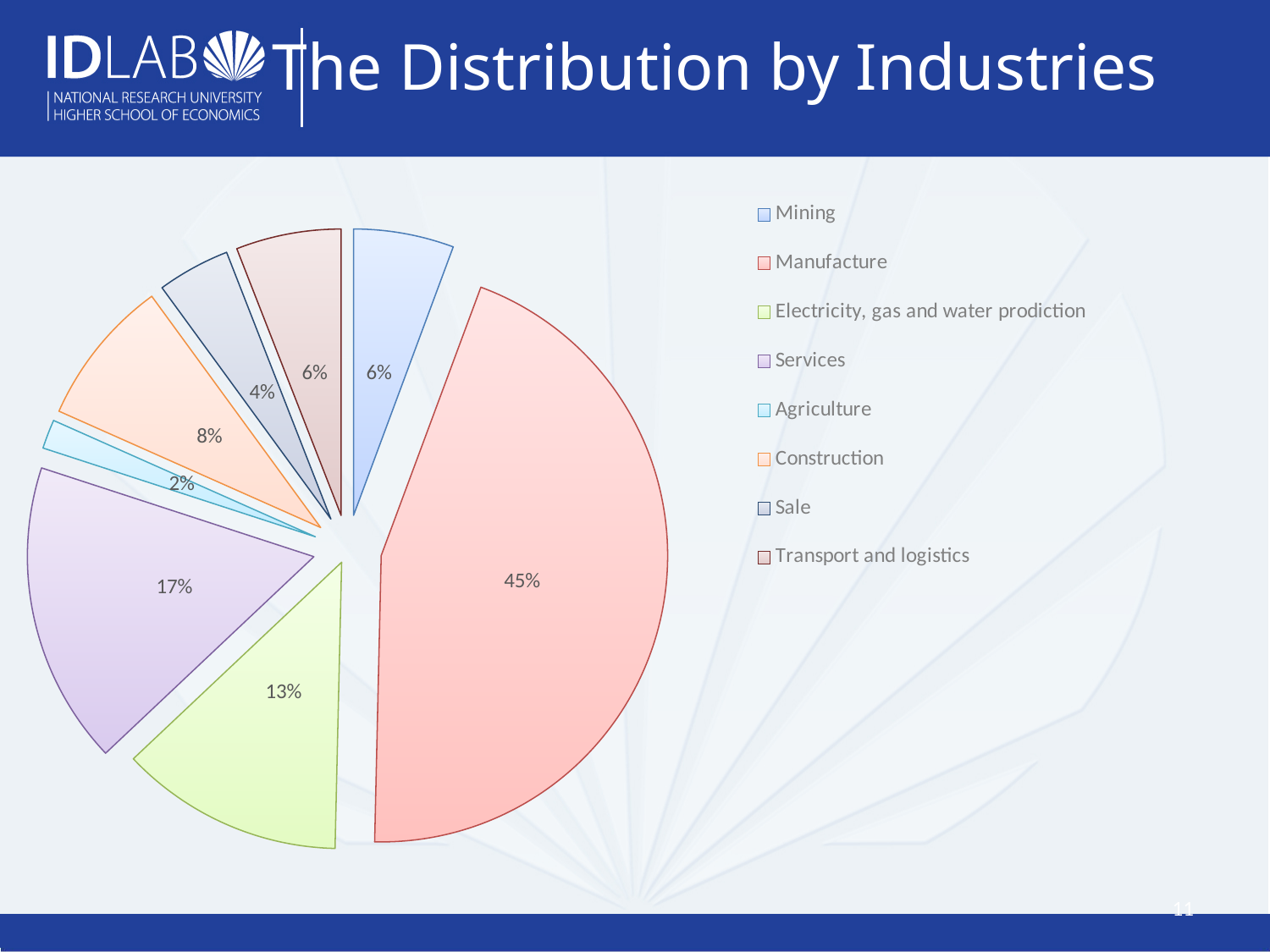
What is the title of the slide? The Distribution by Industries Which industry has the largest share of the pie? Manufacture How many industries are listed in the legend? 8 What is the value for Agriculture? 2% What is the value for Electricity, gas and water prodiction? 13% What is the value for Construction? 8% What is the difference between the shares of Services and Electricity, gas and water prodiction? 4% Which industry has the smallest share of the pie? Agriculture What kind of chart is shown on the slide? pie chart What share of the pie does Services have? 17% What share of the pie does Manufacture have? 45% Which is larger, the share for Construction or the share for Sale? Construction